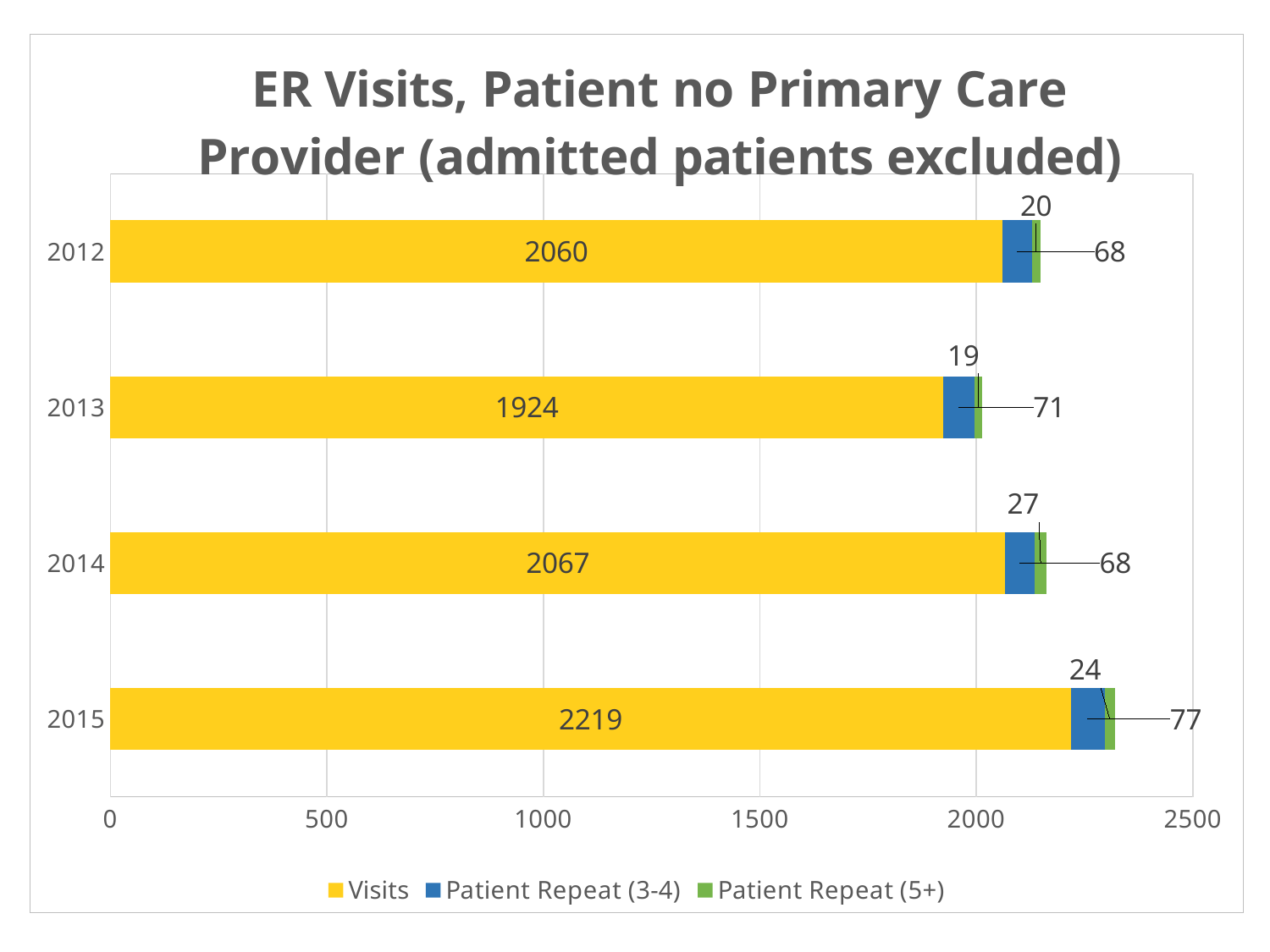
What is the number of Visits for 2015? 2219 What is the Patient Repeat (3-4) value for 2013? 71 How many years are shown on the chart? 4 What is the total of the stacked bar for 2015? 2320 What kind of chart is shown? stacked bar chart What is the difference in Visits between 2015 and 2013? 295 Which is larger, the Visits value for 2012 or for 2014? 2014 Which year has the lowest number of Visits? 2013 Which year has the highest number of Visits? 2015 Is the Visits value for 2013 greater or less than 2000? less How many series does the legend list? 3 What is the Patient Repeat (5+) value for 2014? 27